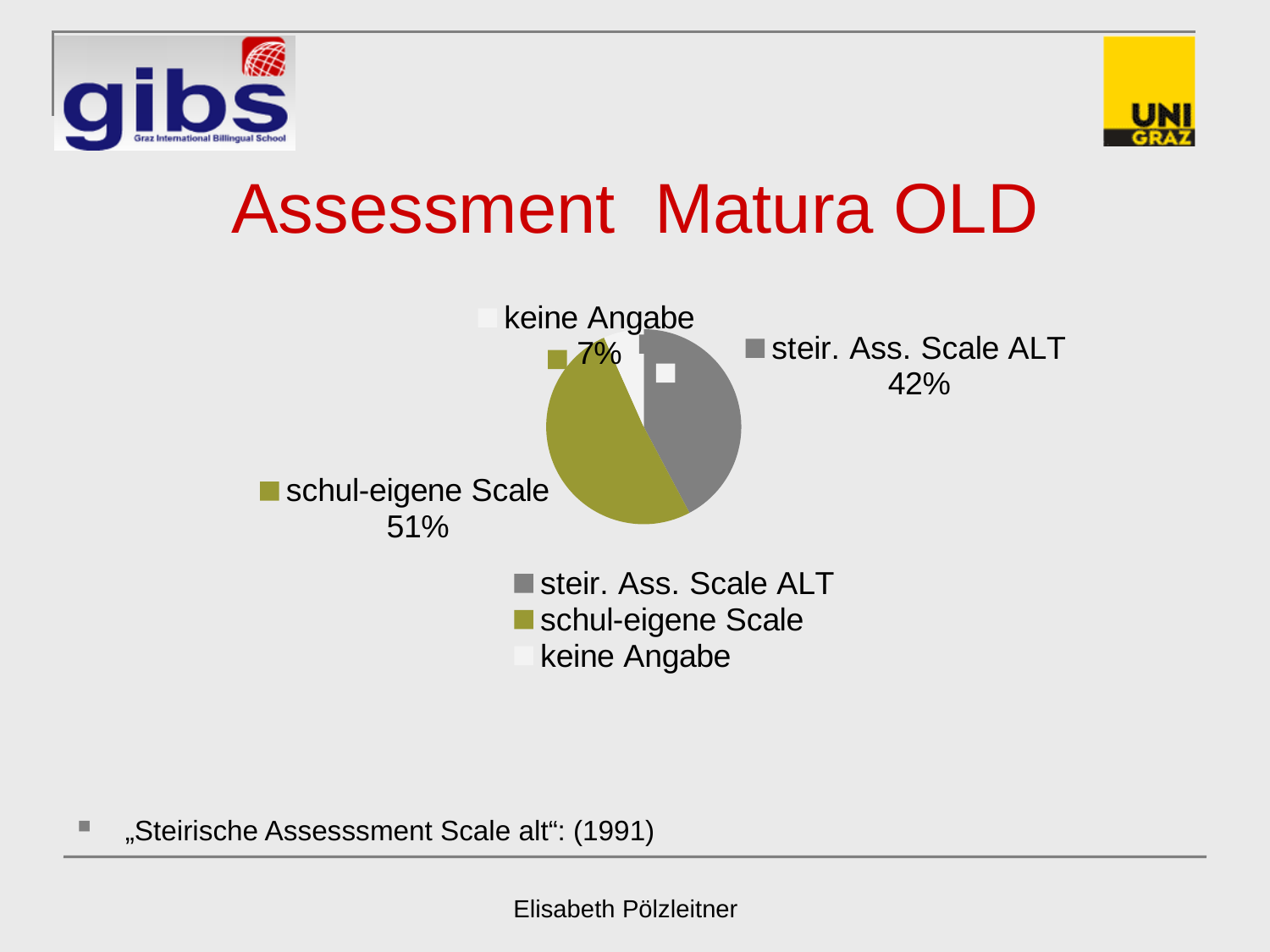
What share of the pie does "schul-eigene Scale" have? 51% What share of the pie does "keine Angabe" have? 7% Which category has the largest slice of the pie? schul-eigene Scale How many categories does the pie chart have? 3 What is the difference in percentage points between "steir. Ass. Scale ALT" and "keine Angabe"? 35 percentage points Which is larger: the share for "schul-eigene Scale" or the share for "steir. Ass. Scale ALT"? schul-eigene Scale What is the difference in percentage points between "schul-eigene Scale" and "steir. Ass. Scale ALT"? 9 percentage points What kind of chart is shown on the slide? pie chart What is the title of the slide containing the pie chart? Assessment Matura OLD How many entries does the legend list? 3 What share of the pie does "steir. Ass. Scale ALT" have? 42% Which category has the smallest slice of the pie? keine Angabe